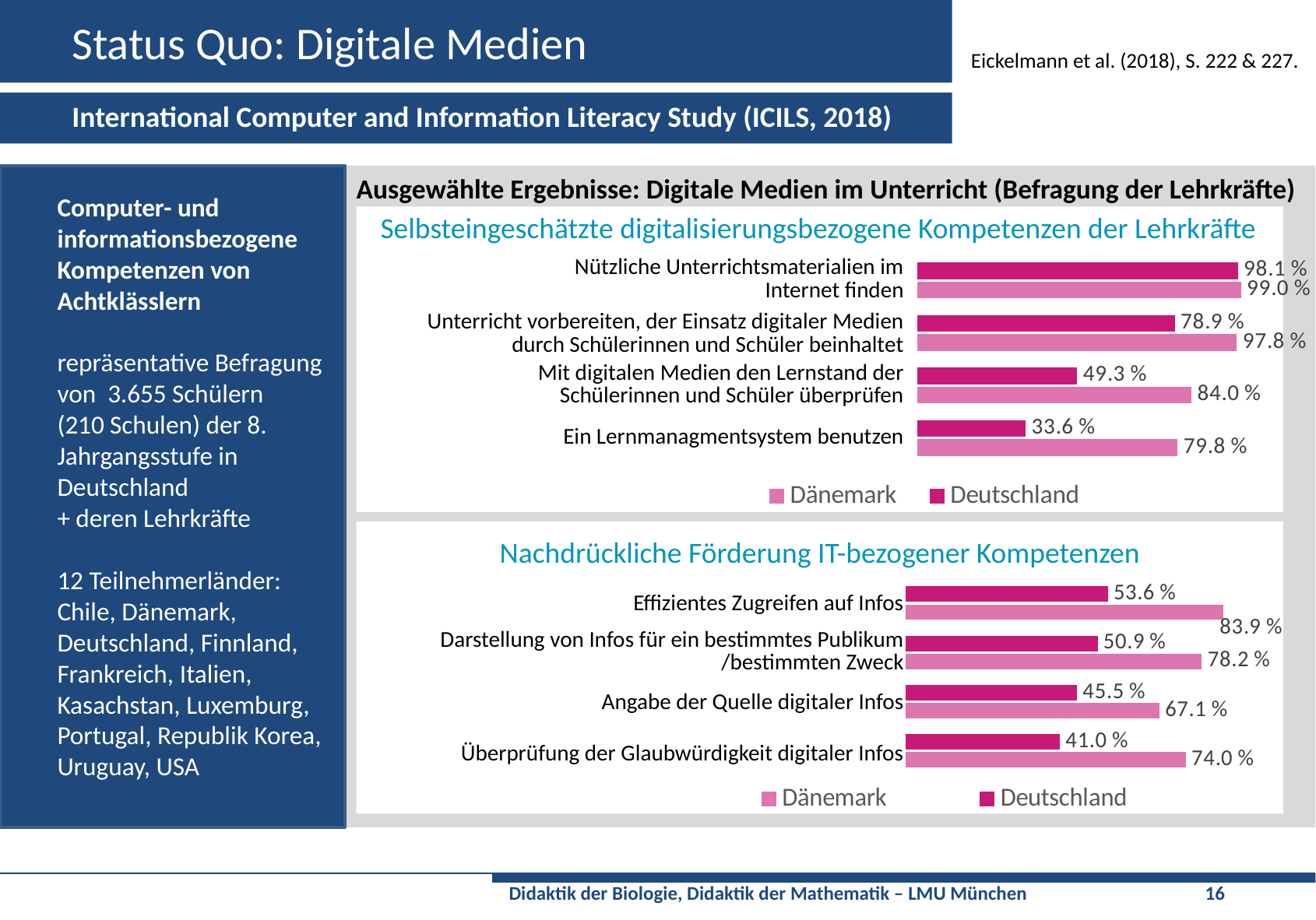
In the chart 'Selbsteingeschätzte digitalisierungsbezogene Kompetenzen der Lehrkräfte', what is the value for Deutschland for 'Ein Lernmanagmentsystem benutzen'? 33.6 % In the chart 'Nachdrückliche Förderung IT-bezogener Kompetenzen', what is the value for Deutschland for 'Überprüfung der Glaubwürdigkeit digitaler Infos'? 41.0 % In the chart 'Nachdrückliche Förderung IT-bezogener Kompetenzen', which is larger for 'Darstellung von Infos für ein bestimmtes Publikum/bestimmten Zweck': Dänemark or Deutschland? Dänemark In the chart 'Nachdrückliche Förderung IT-bezogener Kompetenzen', what is the value for Dänemark for 'Angabe der Quelle digitaler Infos'? 67.1 % What kind of chart is 'Nachdrückliche Förderung IT-bezogener Kompetenzen'? Bar chart In the chart 'Selbsteingeschätzte digitalisierungsbezogene Kompetenzen der Lehrkräfte', which category has the lowest value for Deutschland? Ein Lernmanagmentsystem benutzen In the chart 'Nachdrückliche Förderung IT-bezogener Kompetenzen', which category has the highest value for Dänemark? Effizientes Zugreifen auf Infos In the chart 'Selbsteingeschätzte digitalisierungsbezogene Kompetenzen der Lehrkräfte', what is the difference between Dänemark and Deutschland for 'Mit digitalen Medien den Lernstand der Schülerinnen und Schüler überprüfen'? 34.7 % In the chart 'Nachdrückliche Förderung IT-bezogener Kompetenzen', what is the difference between Dänemark and Deutschland for 'Effizientes Zugreifen auf Infos'? 30.3 % In the chart 'Selbsteingeschätzte digitalisierungsbezogene Kompetenzen der Lehrkräfte', what is the value for Dänemark for 'Unterricht vorbereiten, der Einsatz digitaler Medien durch Schülerinnen und Schüler beinhaltet'? 97.8 % In the chart 'Selbsteingeschätzte digitalisierungsbezogene Kompetenzen der Lehrkräfte', how many series does the legend list? 2 In the chart 'Selbsteingeschätzte digitalisierungsbezogene Kompetenzen der Lehrkräfte', how many categories are shown? 4